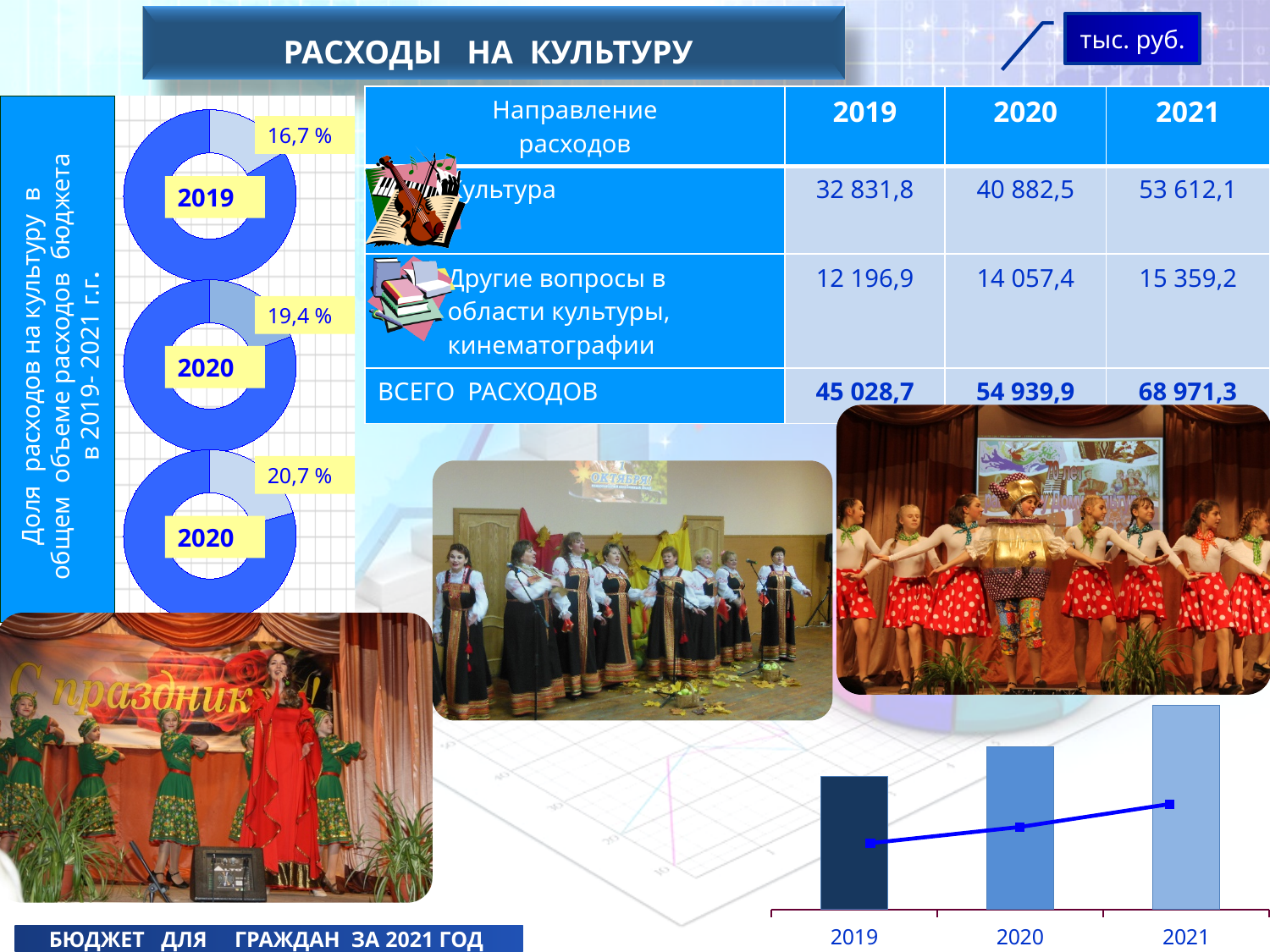
In the top donut chart on the left, labelled 2019, what percentage is shown? 16,7 % In the bar chart in the bottom right corner, do the bars rise or fall from 2019 to 2021? rise In the middle donut chart on the left, labelled 2020, what percentage is shown? 19,4 % What is the difference between the percentage in the middle donut chart (19,4 %) and the top donut chart (16,7 %)? 2,7 % In the bottom donut chart on the left, what percentage is shown? 20,7 % Among the three donut charts on the left, which one shows the highest percentage? the bottom one (20,7 %) Among the three donut charts on the left, which one shows the lowest percentage? the top one, 2019 (16,7 %) How many donut charts are shown on the left side of the slide? 3 Which is larger: the percentage in the bottom donut chart or in the middle donut chart? the bottom donut chart (20,7 %) What type of chart is shown in the bottom right corner of the slide? bar chart In the bar chart in the bottom right corner, which year has the tallest bar? 2021 In the bar chart in the bottom right corner, how many categories are shown on the x axis? 3